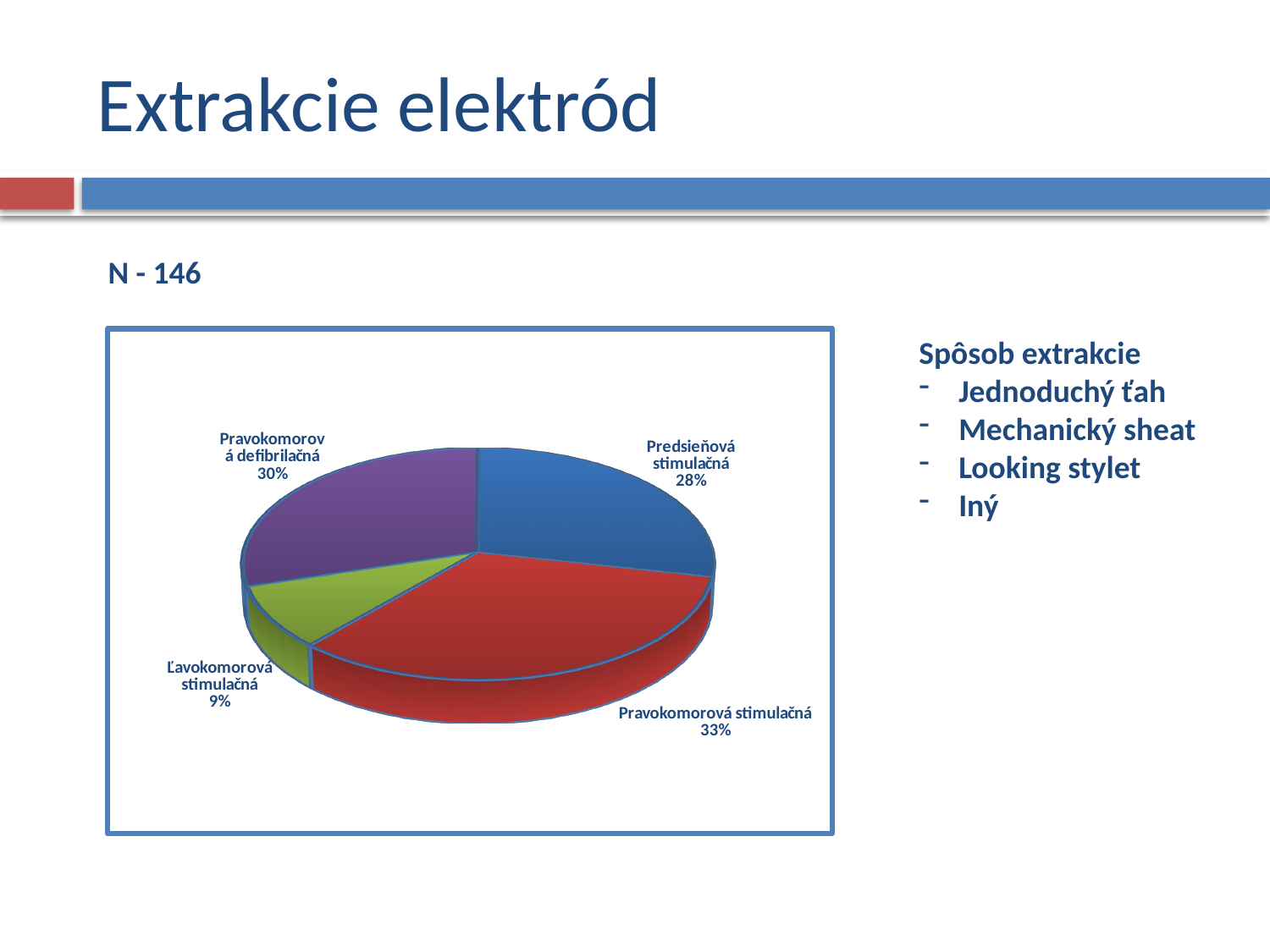
Which category has the smallest slice of the pie? Ľavokomorová stimulačná What is the difference in percentage points between Pravokomorová defibrilačná and Predsieňová stimulačná? 2 What share of the pie does Pravokomorová defibrilačná have? 30% Which is larger, Pravokomorová defibrilačná or Predsieňová stimulačná? Pravokomorová defibrilačná Which category has the largest slice of the pie? Pravokomorová stimulačná What share of the pie does Pravokomorová stimulačná have? 33% What share of the pie does Ľavokomorová stimulačná have? 9% What kind of chart is shown on the slide? pie chart How many slices does the pie chart have? 4 What is the difference in percentage points between Pravokomorová stimulačná and Ľavokomorová stimulačná? 24 What colour is the Pravokomorová stimulačná slice? red